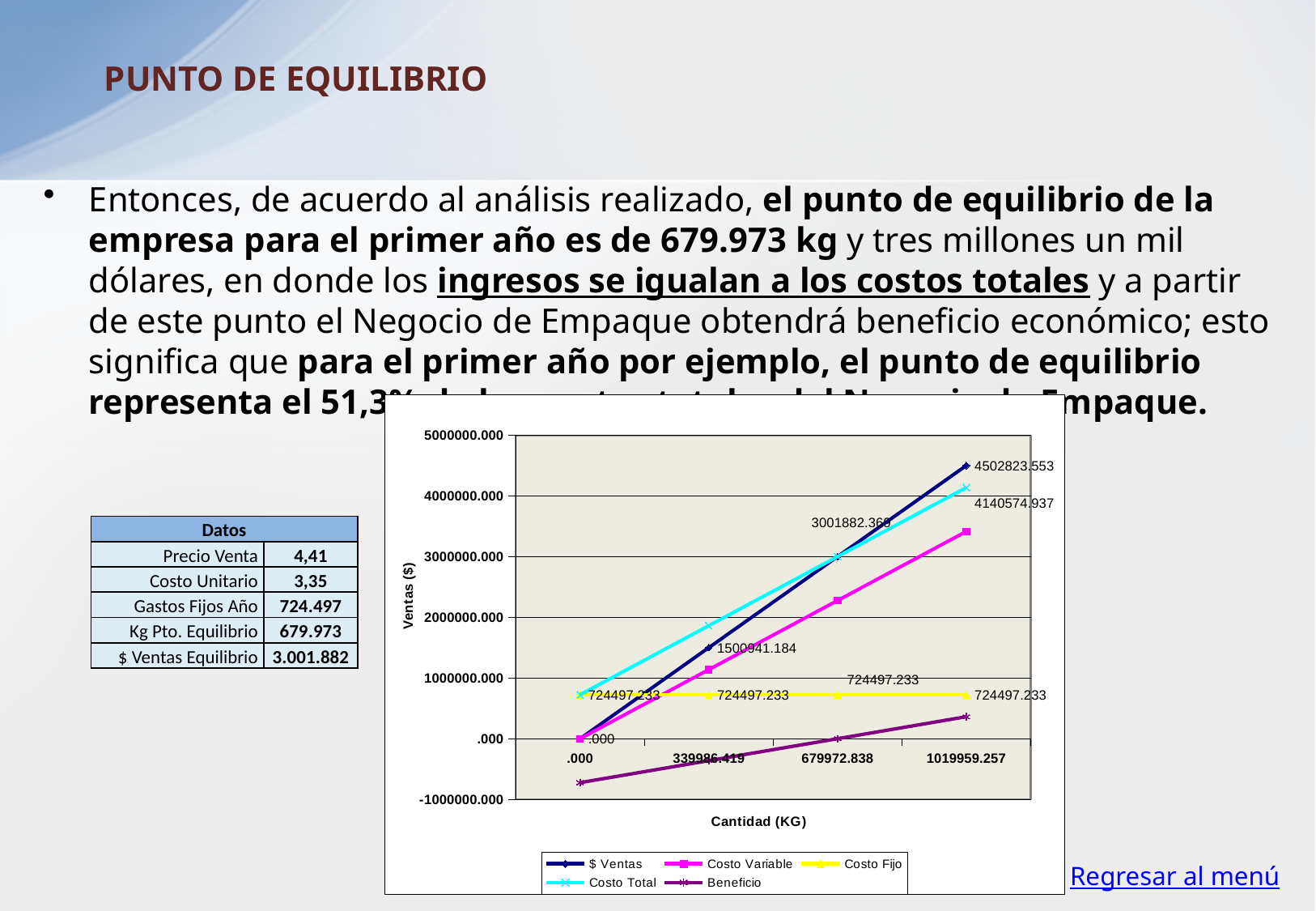
How many series does the chart legend list? 5 How many points are plotted along the x axis (Cantidad (KG))? 4 Is the value of Costo Variable at 1019959.257 kg greater or less than 3000000.000? greater What kind of chart is shown on the slide? line chart Which series has the lowest value at .000 kg? Beneficio What is the value of $ Ventas at 1019959.257 kg? 4502823.553 What is the value of Costo Total at 1019959.257 kg? 4140574.937 At 1019959.257 kg, which is larger: $ Ventas or Costo Total? $ Ventas What is the value of Costo Fijo at 679972.838 kg? 724497.233 What is the value of $ Ventas at 339986.419 kg? 1500941.184 What is the title of the x axis of the chart? Cantidad (KG) What is the difference between $ Ventas and Costo Total at 1019959.257 kg? 362248.616